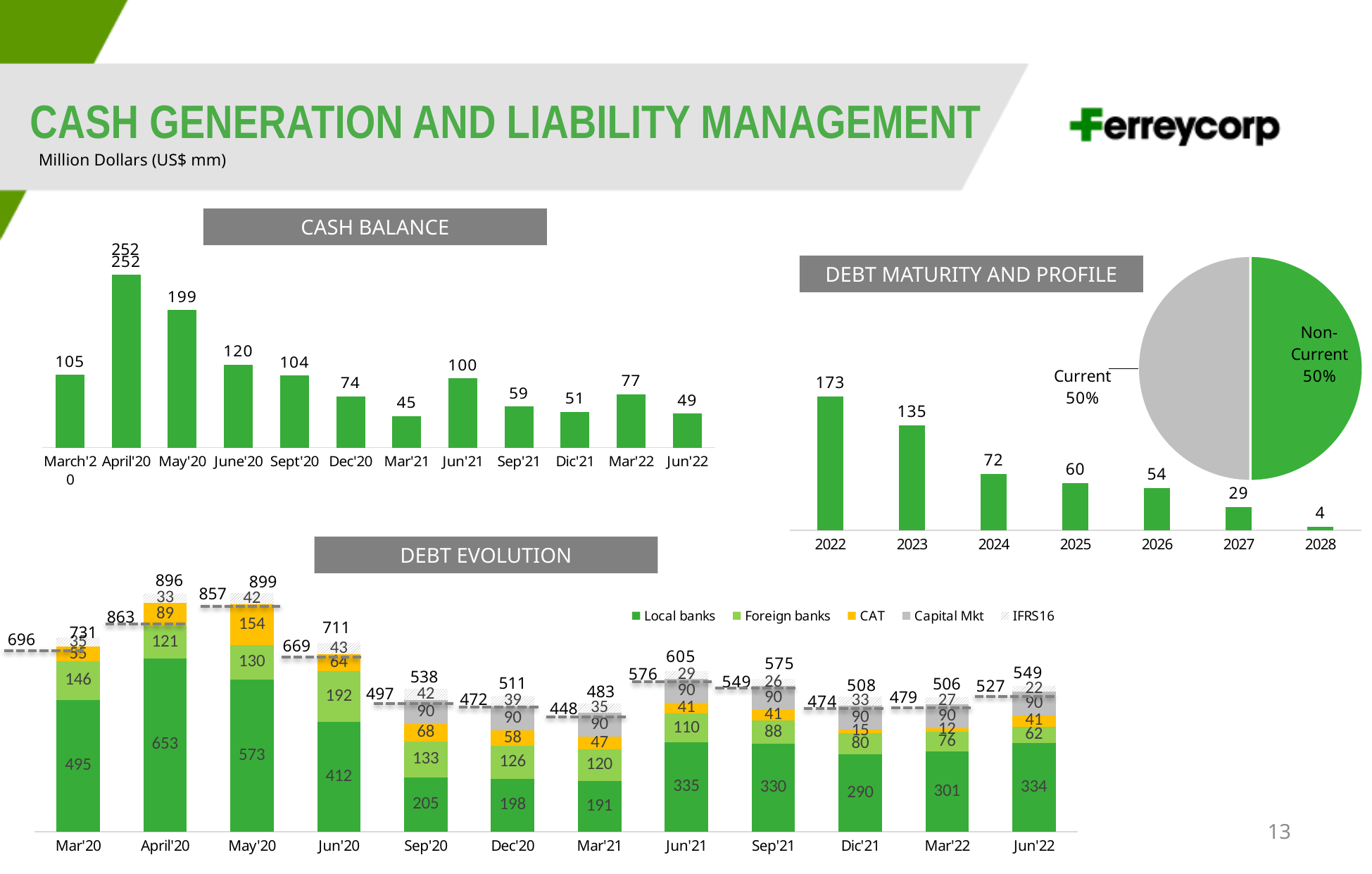
In the Cash Balance chart, how many periods are shown? 12 In the pie chart next to Debt Maturity and Profile, what share of debt is Non-Current? 50% In the Debt Evolution chart, what is the total debt for Jun'22? 549 In the Cash Balance chart, what is the cash balance for April'20? 252 In the Cash Balance chart, which period has the lowest cash balance? Mar'21 In the Debt Evolution chart, how many series does the legend list? 5 In the Debt Evolution chart, which is larger, the Foreign banks value for Jun'20 or for Sep'20? Jun'20 In the Debt Evolution chart, what is the Local banks value for April'20? 653 In the Debt Maturity and Profile chart, what is the debt maturing in 2023? 135 In the Debt Maturity and Profile chart, which year has the highest debt maturity? 2022 In the Debt Maturity and Profile chart, do the values rise or fall from 2022 to 2028? fall In the Cash Balance chart, what is the difference between the cash balance in May'20 and in June'20? 79